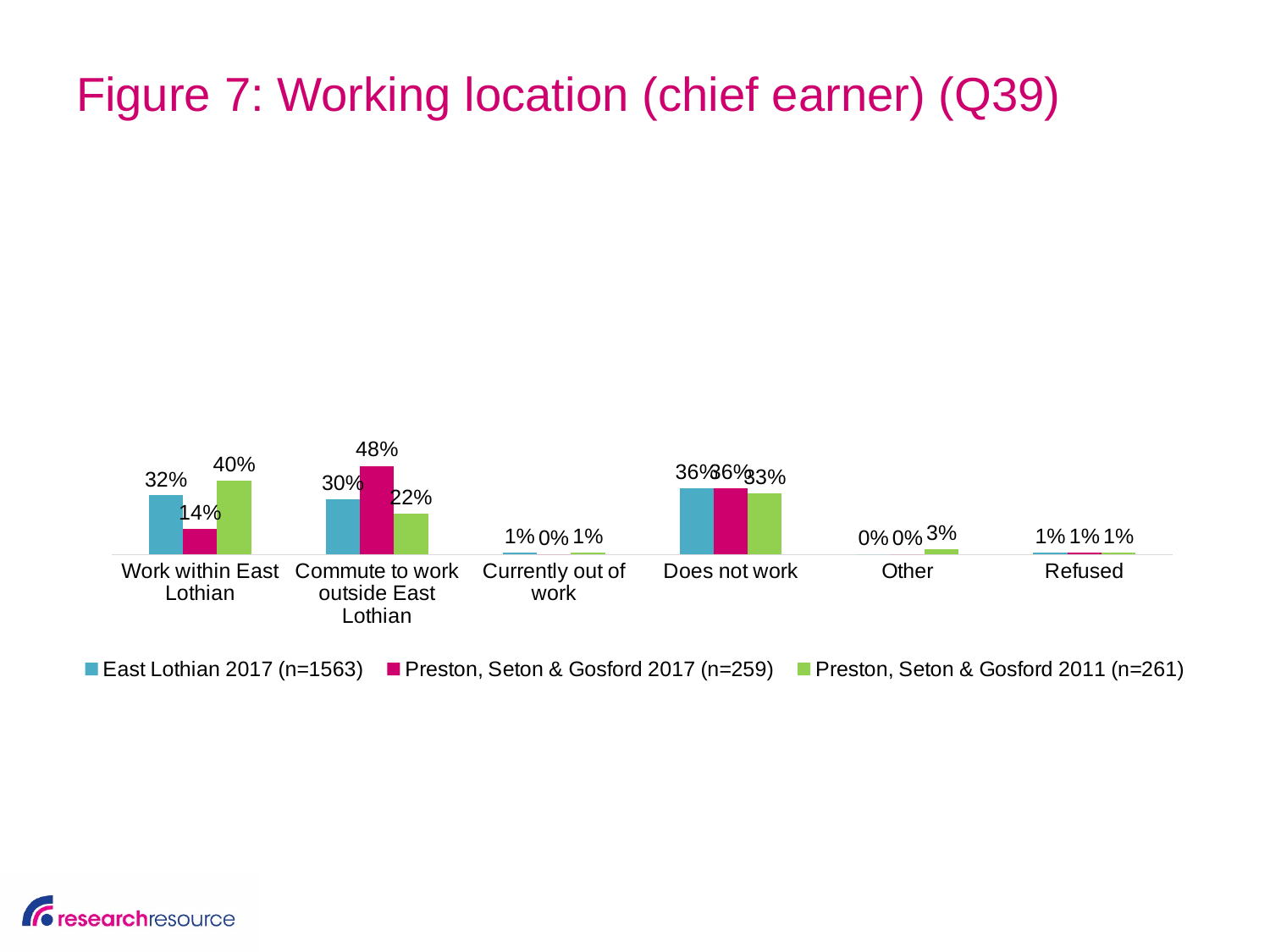
Which category has the highest value for Preston, Seton & Gosford 2011 (n=261)? Work within East Lothian How many categories are shown on the x axis? 6 What kind of chart is shown on the slide? Bar chart What is the value for East Lothian 2017 (n=1563) in the 'Work within East Lothian' category? 32% In the 'Commute to work outside East Lothian' category, which is larger: the East Lothian 2017 (n=1563) value or the Preston, Seton & Gosford 2011 (n=261) value? East Lothian 2017 (n=1563) Which category has the highest value for Preston, Seton & Gosford 2017 (n=259)? Commute to work outside East Lothian What is the value for Preston, Seton & Gosford 2011 (n=261) in the 'Other' category? 3% What is the value for Preston, Seton & Gosford 2017 (n=259) in the 'Commute to work outside East Lothian' category? 48% How many series does the legend list? 3 What is the title of the chart? Figure 7: Working location (chief earner) (Q39) What is the difference between the Preston, Seton & Gosford 2011 (n=261) and Preston, Seton & Gosford 2017 (n=259) values in the 'Work within East Lothian' category? 26% What is the difference between the East Lothian 2017 (n=1563) value and the Preston, Seton & Gosford 2011 (n=261) value in the 'Does not work' category? 3%